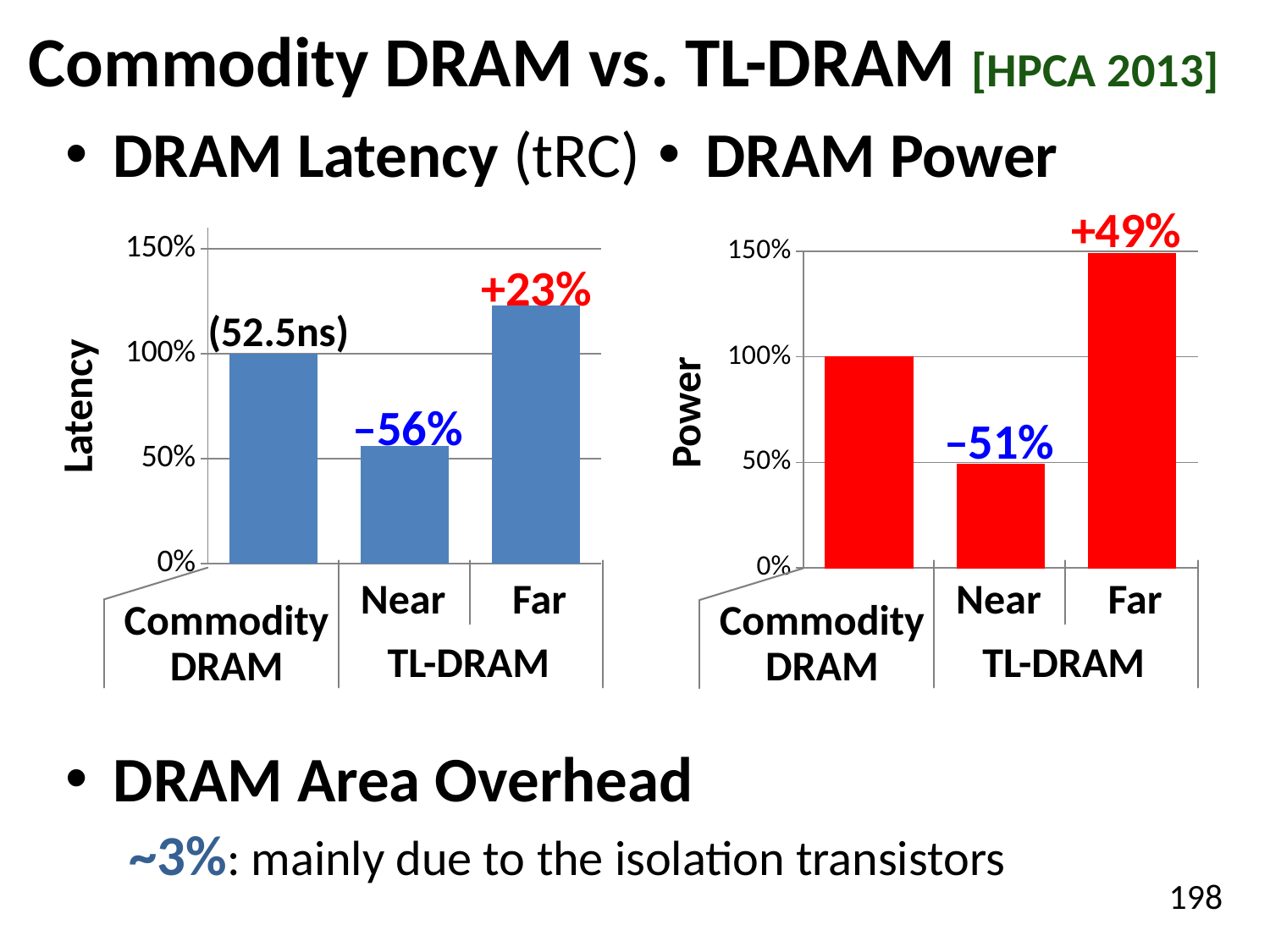
What kind of chart is the DRAM Latency chart? bar chart In the DRAM Power chart, which bar is the lowest? Near In the DRAM Latency chart, what percentage change is labelled above the Near bar? –56% In the DRAM Power chart, is the value for Near greater or less than 100%? less In the DRAM Power chart, what is the value for Commodity DRAM? 100% In the DRAM Power chart, what percentage change is labelled above the Near bar? –51% In the DRAM Latency chart, is the value for Far greater or less than 100%? greater How many bars are plotted in the DRAM Power chart? 3 In the DRAM Latency chart, what percentage change is labelled above the Far bar? +23% In the DRAM Latency chart, what is the value for Commodity DRAM? 100% In the DRAM Latency chart, which bar is the highest? Far In the DRAM Power chart, what percentage change is labelled above the Far bar? +49%